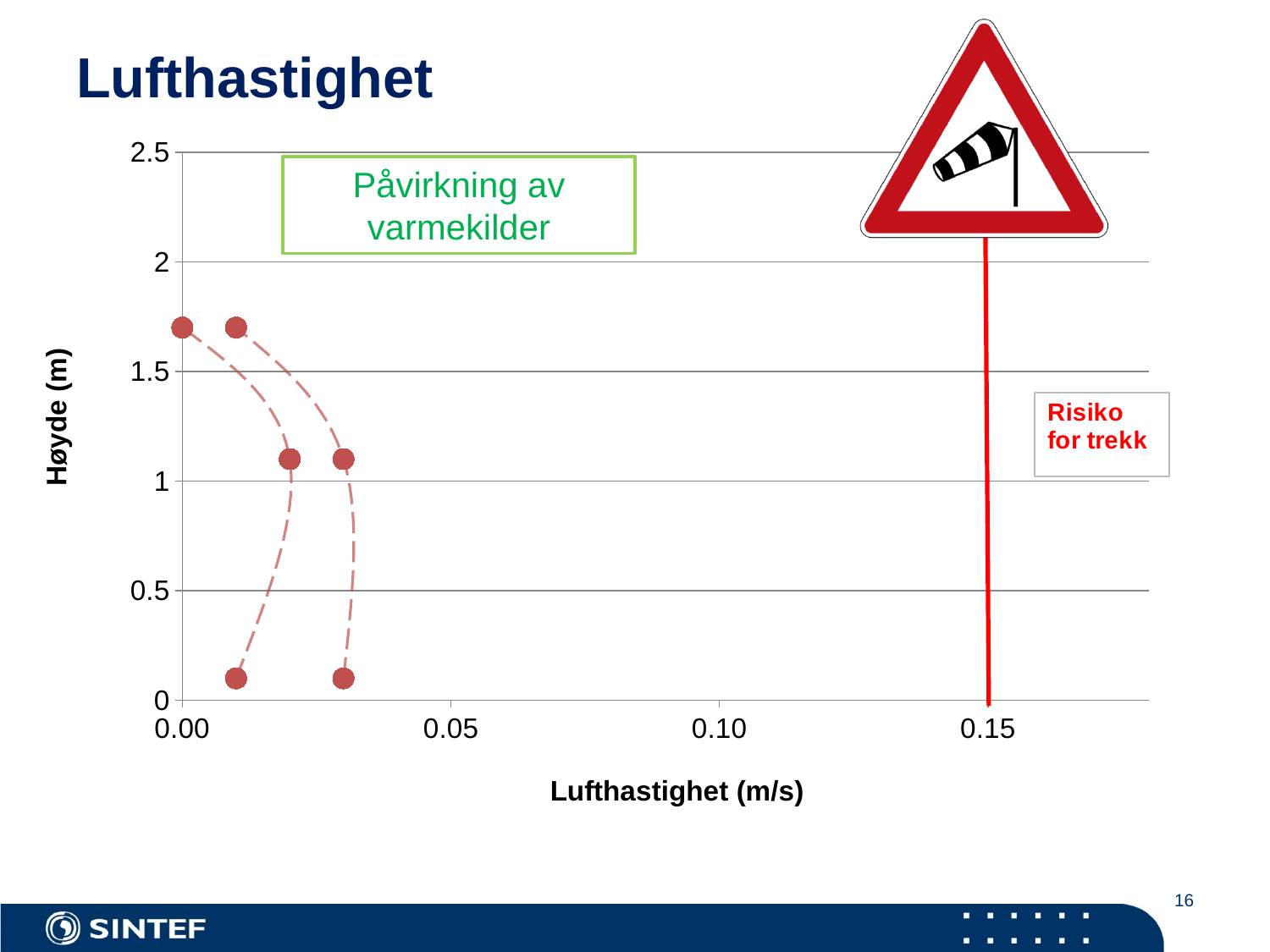
Is the height of the lowest data points greater or less than 0.5 m? less Is the height of the topmost data points greater or less than 1.5 m? greater What kind of chart is shown on the slide? scatter chart with dashed curves How many data points are plotted in total on the chart? 6 How many dashed curves are plotted on the chart? 2 What is the air speed (Lufthastighet) of the leftmost data point on the chart? 0.00 What is the label of the x axis? Lufthastighet (m/s) What label is written next to the vertical red line? Risiko for trekk Is the air speed of the rightmost data point on the chart greater or less than 0.05? less How many data points are plotted on each dashed curve? 3 At which air speed value on the x axis is the vertical red line drawn? 0.15 What is the highest value shown on the y axis (Høyde)? 2.5